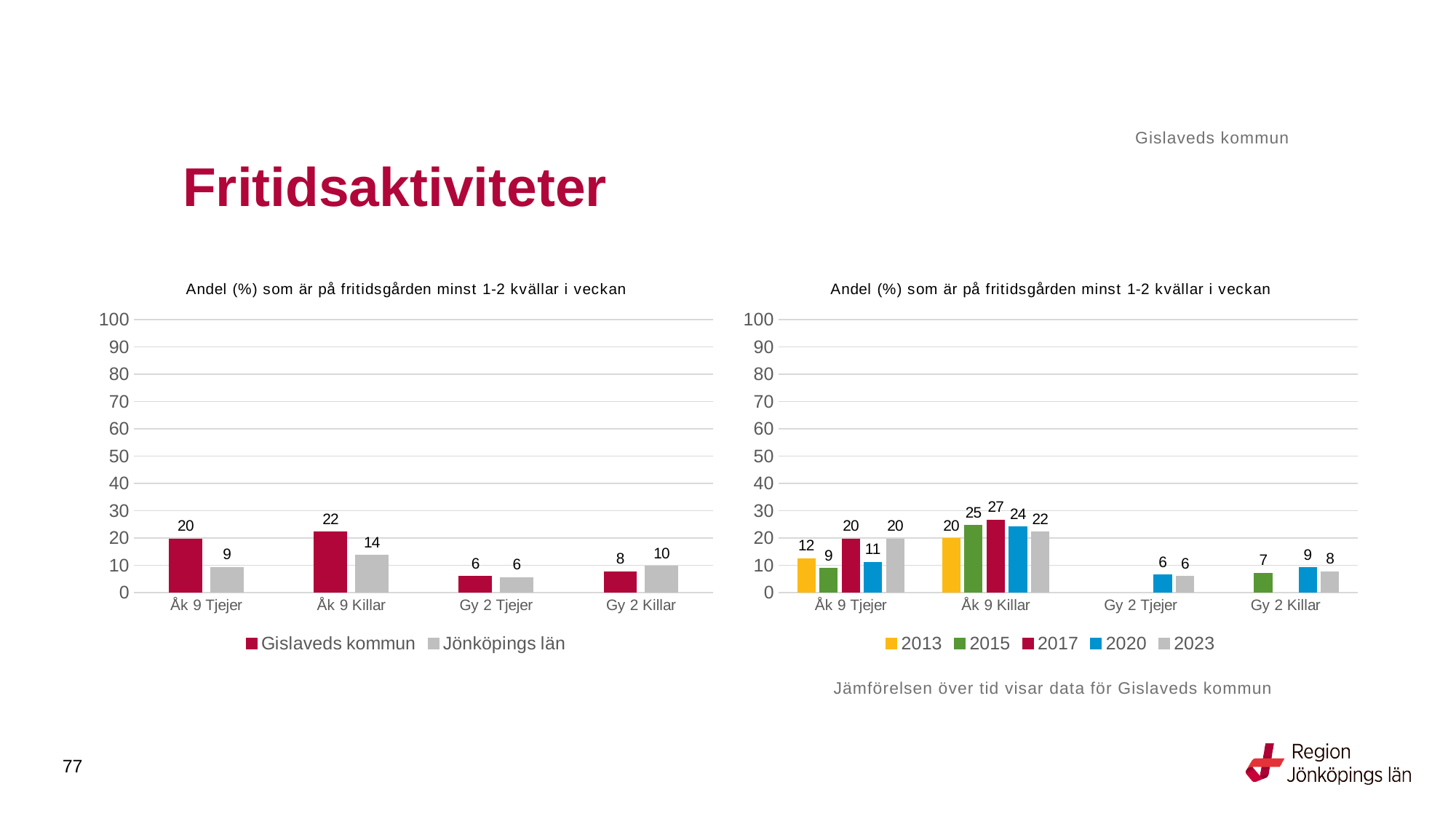
In the right chart, what is the value for 2017 for Åk 9 Killar? 27 In the left chart, what is the value for Jönköpings län for Gy 2 Killar? 10 In the left chart, which category has the highest value for Gislaveds kommun? Åk 9 Killar In the left chart, which is larger for Gy 2 Killar: Gislaveds kommun or Jönköpings län? Jönköpings län In the left chart, what is the value for Gislaveds kommun for Åk 9 Killar? 22 In the left chart, what is the difference between Gislaveds kommun and Jönköpings län for Åk 9 Tjejer? 11 In the right chart, which year has the lowest value for Åk 9 Tjejer? 2015 How many series does the legend of the left chart list? 2 In the right chart, what is the difference between 2015 and 2023 for Gy 2 Killar? 1 How many series does the legend of the right chart list? 5 In the right chart, what is the value for 2013 for Åk 9 Tjejer? 12 What kind of chart is the right chart? Bar chart